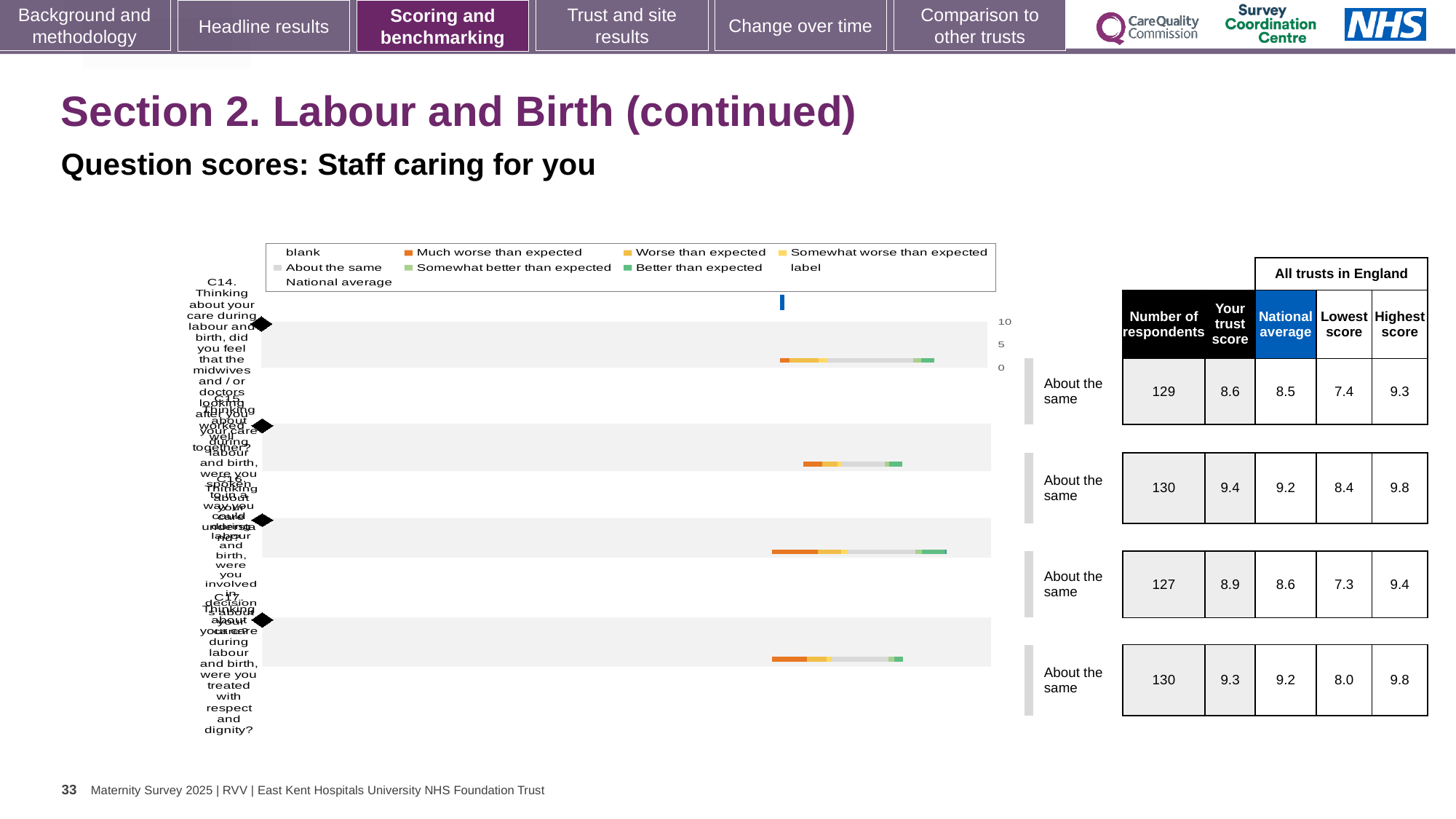
What kind of chart is shown on the slide? bar chart What benchmark category label is shown next to each of the four bars? About the same In the first row of the table, what is the difference between 'Your trust score' and the national average? 0.1 What colour represents 'Much worse than expected' in the chart legend? orange In the third row of the table, which is larger: 'Your trust score' or the national average? Your trust score (8.9) In the table, what is the lowest score for the fourth (bottom) row? 8.0 In the table, what is 'Your trust score' for the second row? 9.4 Which row of the table has the lowest 'Your trust score'? the first row (8.6) Which row of the table has the highest 'Your trust score'? the second row (9.4) In the table, what is the highest score for the third row? 9.4 How many question rows (bars) are plotted in the chart? 4 In the table, what is the number of respondents for the first (top) row? 129